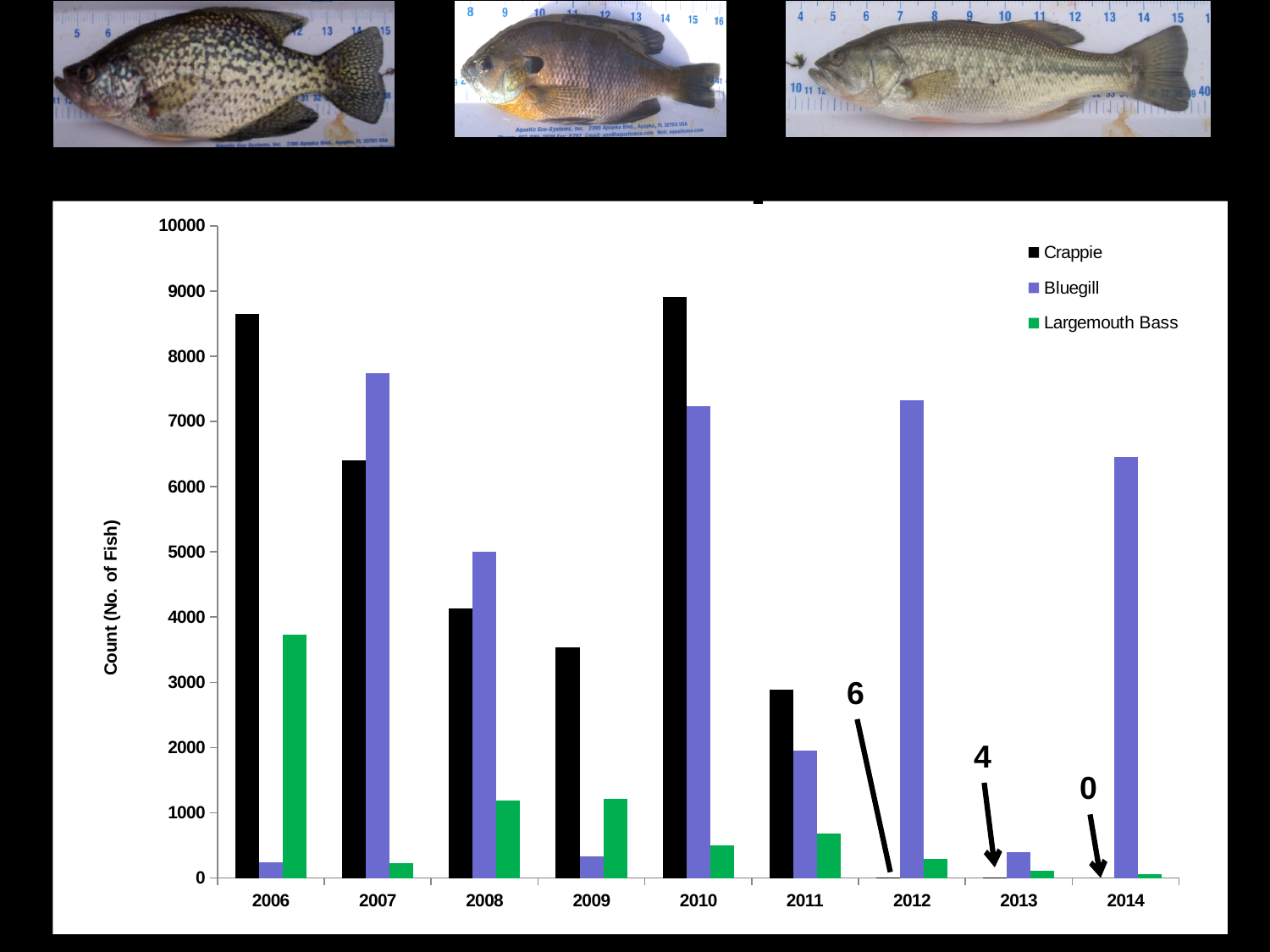
What kind of chart is shown on the slide? bar chart Is the Crappie count in 2006 greater or less than 8000? greater What is the Crappie count in 2013? 4 Is the Bluegill count in 2006 greater or less than 1000? less In which year is the Bluegill count highest? 2007 What is the Crappie count in 2012? 6 How many series does the legend list? 3 How many years are shown on the x axis? 9 What is the difference between the Crappie counts in 2012 and 2013? 2 In 2009, which is larger, the Crappie count or the Bluegill count? Crappie In which year is the Largemouth Bass count highest? 2006 What is the Crappie count in 2014? 0